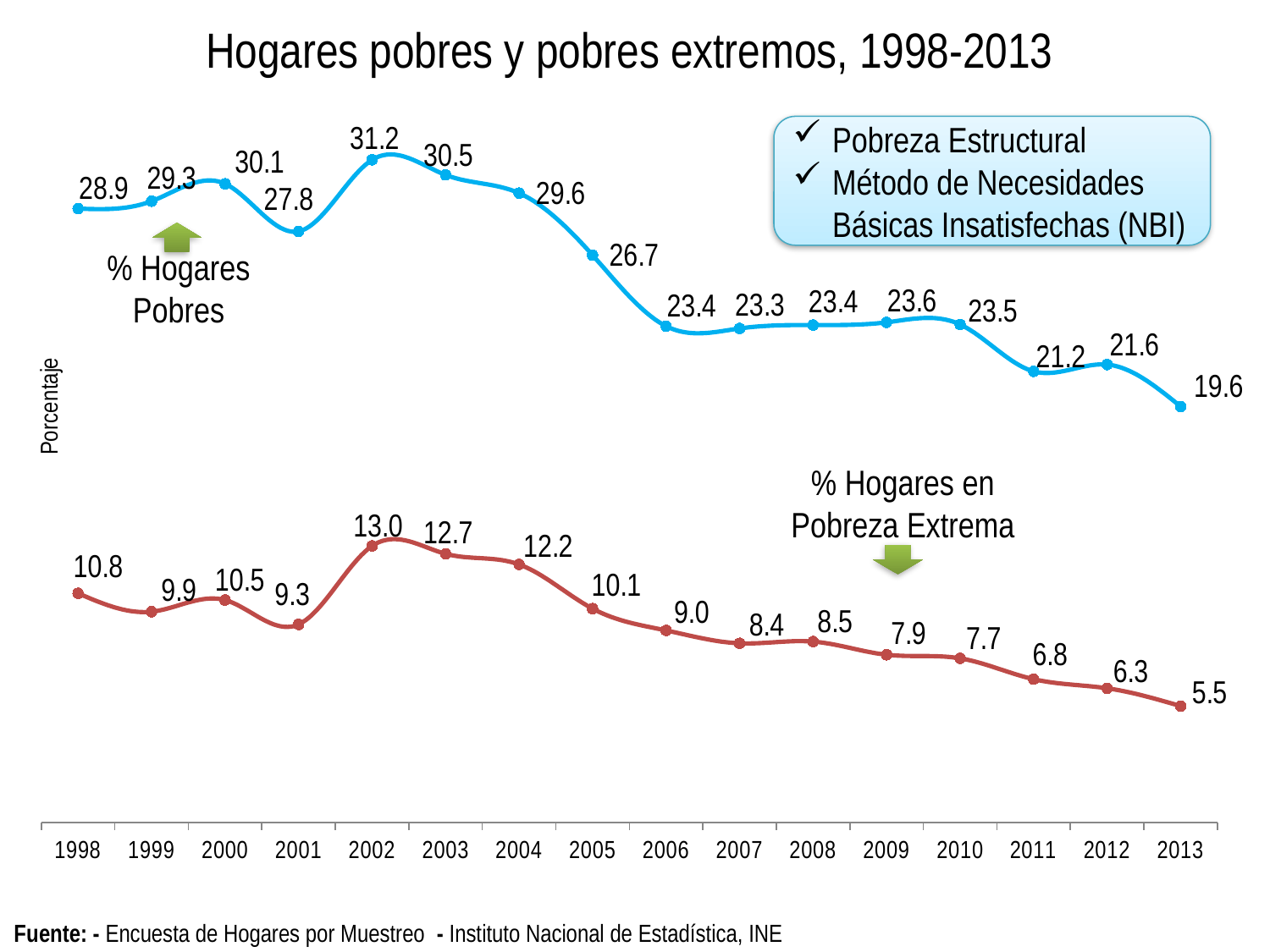
What is the difference between % Hogares Pobres in 2002 and in 2013? 11.6 What is the difference between % Hogares en Pobreza Extrema in 1998 and in 2013? 5.3 What is the value of % Hogares en Pobreza Extrema in 2005? 10.1 How many years are plotted on the x axis? 16 What is the value of % Hogares Pobres in 2002? 31.2 In which year is % Hogares en Pobreza Extrema lowest? 2013 How many data series are plotted on the chart? 2 In which year is % Hogares Pobres highest? 2002 What is the value of % Hogares en Pobreza Extrema in 2013? 5.5 Does % Hogares en Pobreza Extrema rise or fall overall from 1998 to 2013? Fall Which year has a higher % Hogares Pobres, 2011 or 2012? 2012 What kind of chart is shown on the slide? Line chart